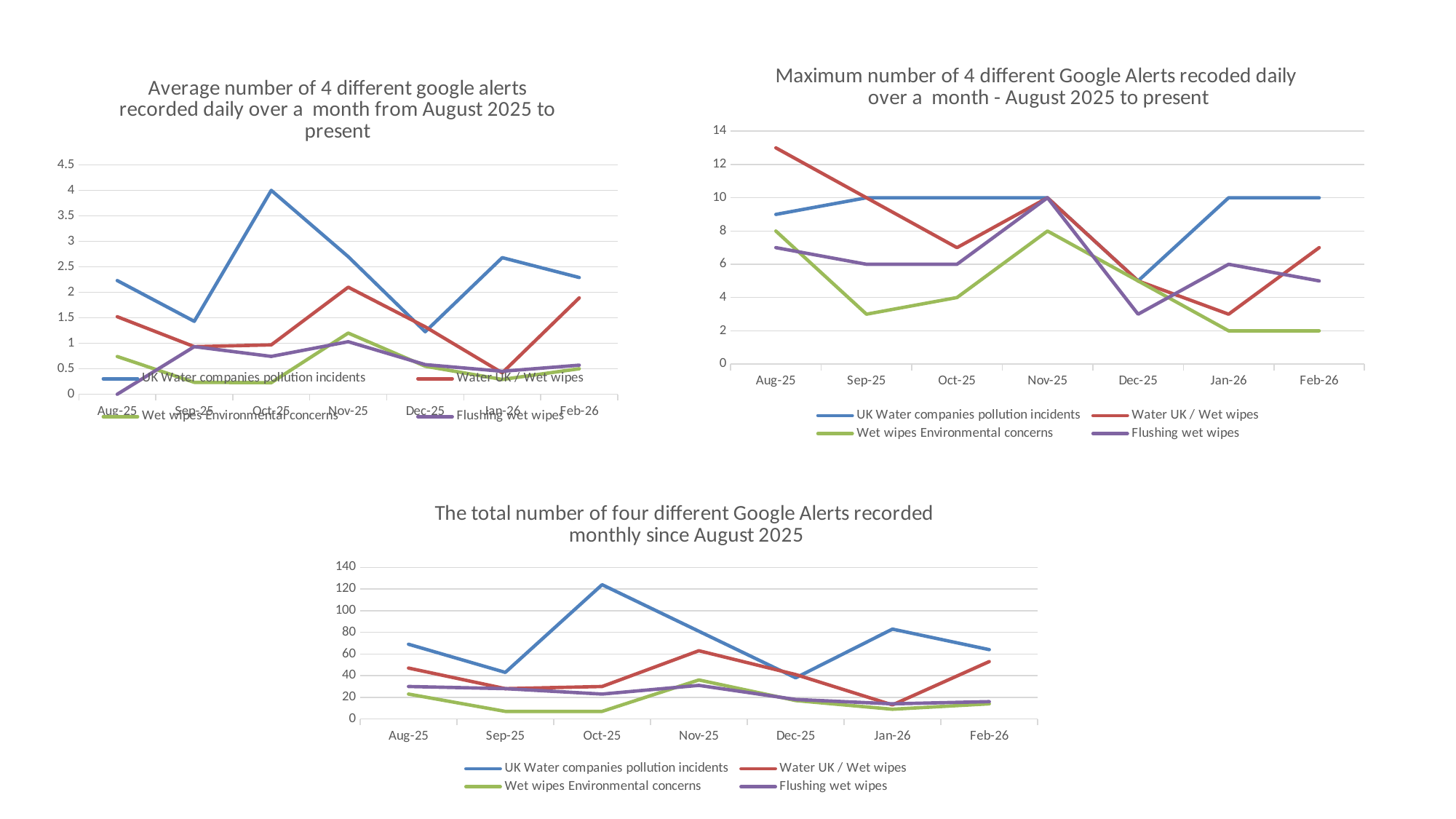
In the chart titled 'Average number of 4 different google alerts recorded daily over a month from August 2025 to present', what is the value for UK Water companies pollution incidents in Oct-25? 4 What kind of chart is the chart titled 'The total number of four different Google Alerts recorded monthly since August 2025'? Line chart In the chart titled 'The total number of four different Google Alerts recorded monthly since August 2025', is the value for UK Water companies pollution incidents in Oct-25 greater or less than 100? greater In the chart titled 'Maximum number of 4 different Google Alerts recoded daily over a month - August 2025 to present', how many series does the legend list? 4 In the chart titled 'Maximum number of 4 different Google Alerts recoded daily over a month - August 2025 to present', which series has the lowest value in Feb-26? Wet wipes Environmental concerns In the chart titled 'The total number of four different Google Alerts recorded monthly since August 2025', which is larger in Aug-25: UK Water companies pollution incidents or Water UK / Wet wipes? UK Water companies pollution incidents In the chart titled 'Average number of 4 different google alerts recorded daily over a month from August 2025 to present', in which month is UK Water companies pollution incidents highest? Oct-25 In the chart titled 'The total number of four different Google Alerts recorded monthly since August 2025', how many months are shown on the x axis? 7 In the chart titled 'Maximum number of 4 different Google Alerts recoded daily over a month - August 2025 to present', what is the value for Wet wipes Environmental concerns in Feb-26? 2 In the chart titled 'Maximum number of 4 different Google Alerts recoded daily over a month - August 2025 to present', what is the value for Flushing wet wipes in Nov-25? 10 In the chart titled 'Maximum number of 4 different Google Alerts recoded daily over a month - August 2025 to present', what is the value for Wet wipes Environmental concerns in Aug-25? 8 In the chart titled 'Maximum number of 4 different Google Alerts recoded daily over a month - August 2025 to present', what is the difference between the Wet wipes Environmental concerns values in Aug-25 and Feb-26? 6